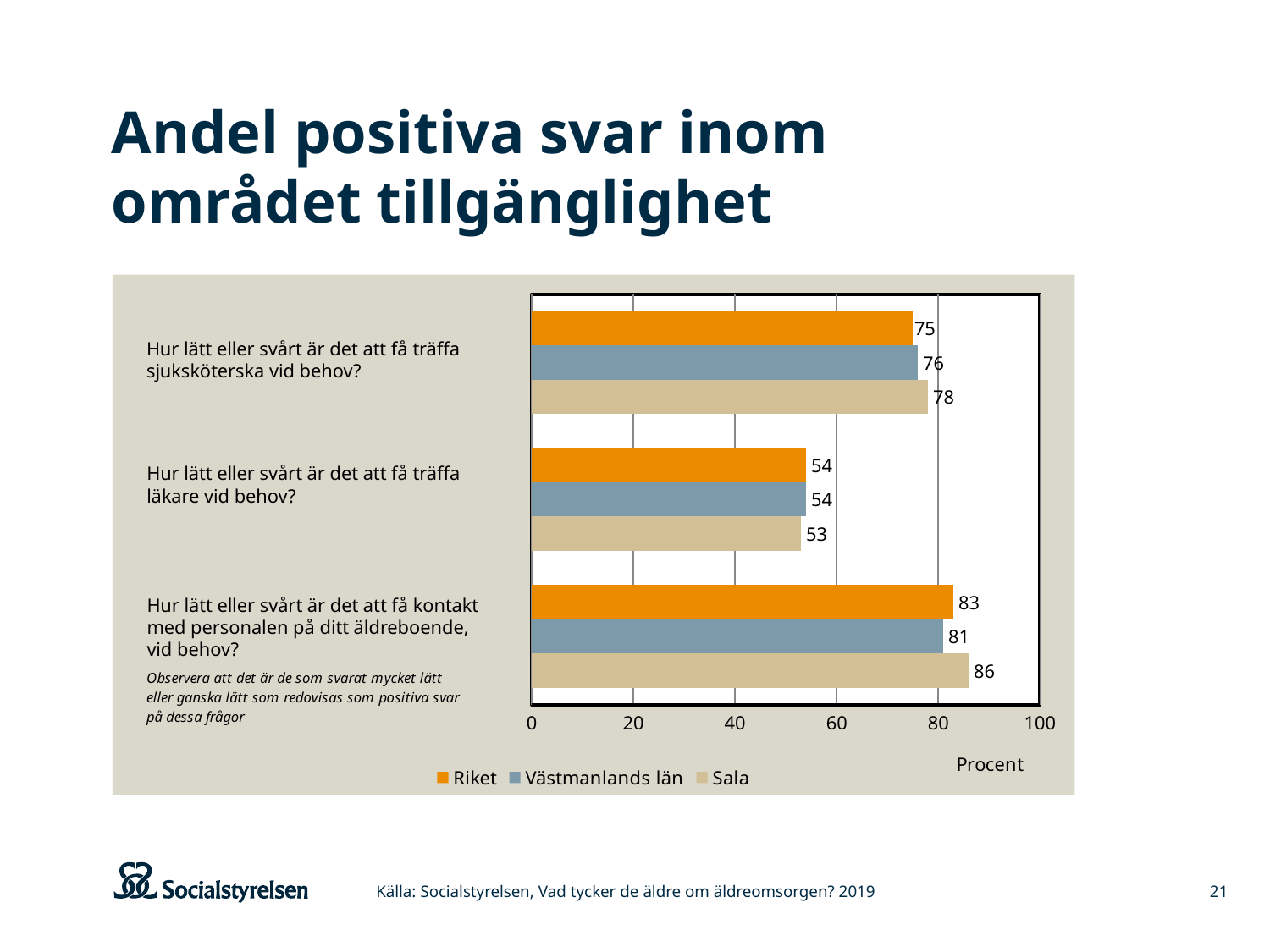
Which series has the highest value on the question about contacting staff at the äldreboende? Sala What is the label on the horizontal axis of the chart? Procent Which question has the lowest value for Sala? Hur lätt eller svårt är det att få träffa läkare vid behov? What is the value for Sala on the question "Hur lätt eller svårt är det att få träffa sjuksköterska vid behov?"? 78 How many series does the legend list? 3 Is the value for Riket on the question about meeting a doctor greater or less than 60? less What is the value for Riket on the question "Hur lätt eller svårt är det att få kontakt med personalen på ditt äldreboende, vid behov?"? 83 Which is larger on the question about meeting a nurse: Riket or Sala? Sala What is the difference between Sala and Västmanlands län on the question about contacting staff at the äldreboende? 5 What kind of chart is shown on the slide? bar chart How many questions (categories) are shown in the chart? 3 What is the value for Västmanlands län on the question "Hur lätt eller svårt är det att få träffa läkare vid behov?"? 54